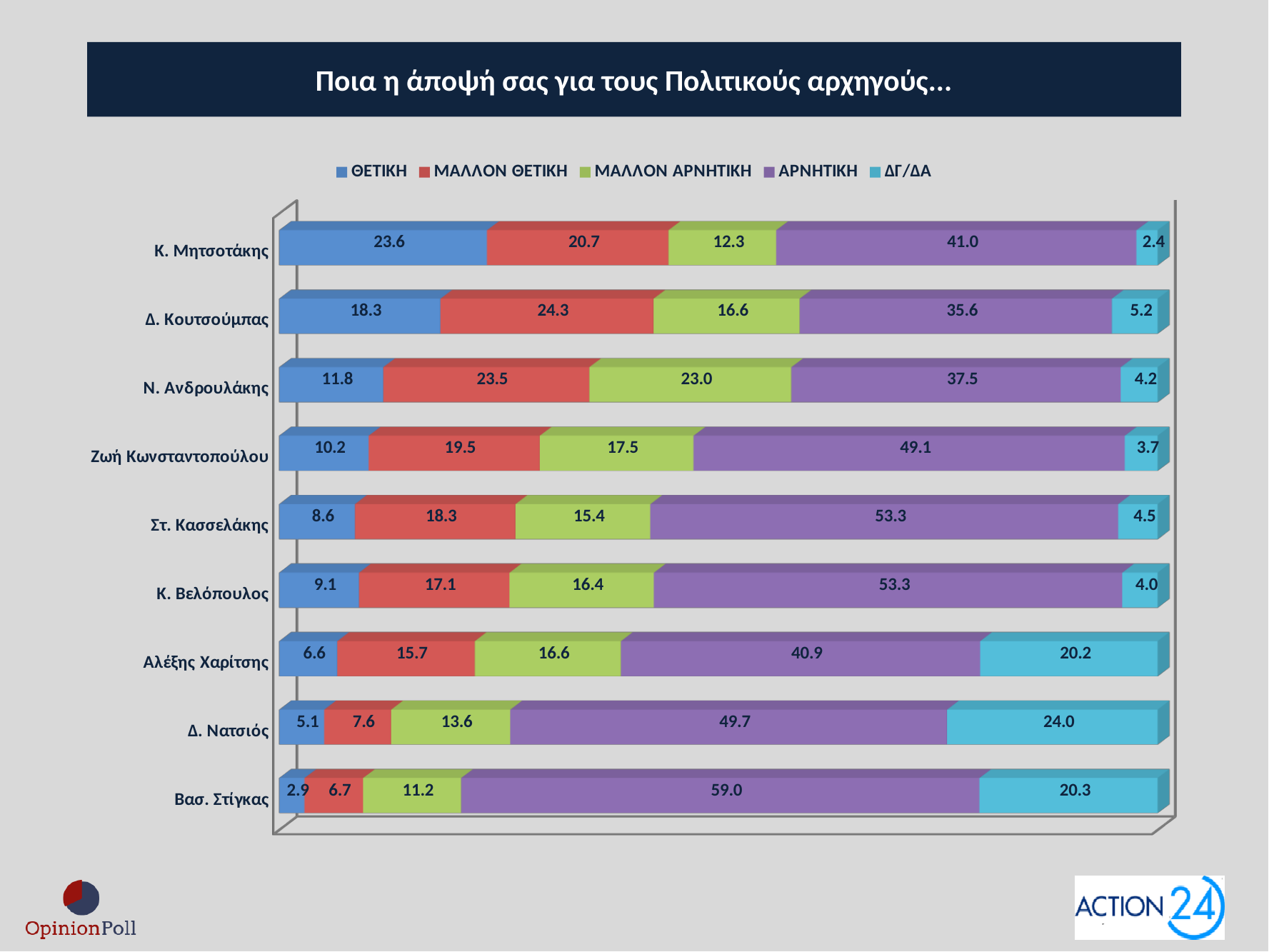
What is the difference between the ΜΑΛΛΟΝ ΘΕΤΙΚΗ values for Δ. Κουτσούμπας and Κ. Μητσοτάκης? 3.6 Which politician has the highest ΑΡΝΗΤΙΚΗ value? Βασ. Στίγκας How many politicians are shown in the chart? 9 Which politician has the lowest ΘΕΤΙΚΗ value? Βασ. Στίγκας What is the ΔΓ/ΔΑ value for Δ. Νατσιός? 24.0 Which politician has the highest ΘΕΤΙΚΗ value? Κ. Μητσοτάκης What is the ΑΡΝΗΤΙΚΗ value for Ζωή Κωνσταντοπούλου? 49.1 What kind of chart is shown on the slide? Stacked bar chart What is the ΘΕΤΙΚΗ value for Κ. Μητσοτάκης? 23.6 Which is larger: the ΜΑΛΛΟΝ ΑΡΝΗΤΙΚΗ value for Ν. Ανδρουλάκης or for Στ. Κασσελάκης? Ν. Ανδρουλάκης What is the total of the stacked bar for Αλέξης Χαρίτσης? 100.0 How many series does the legend list? 5